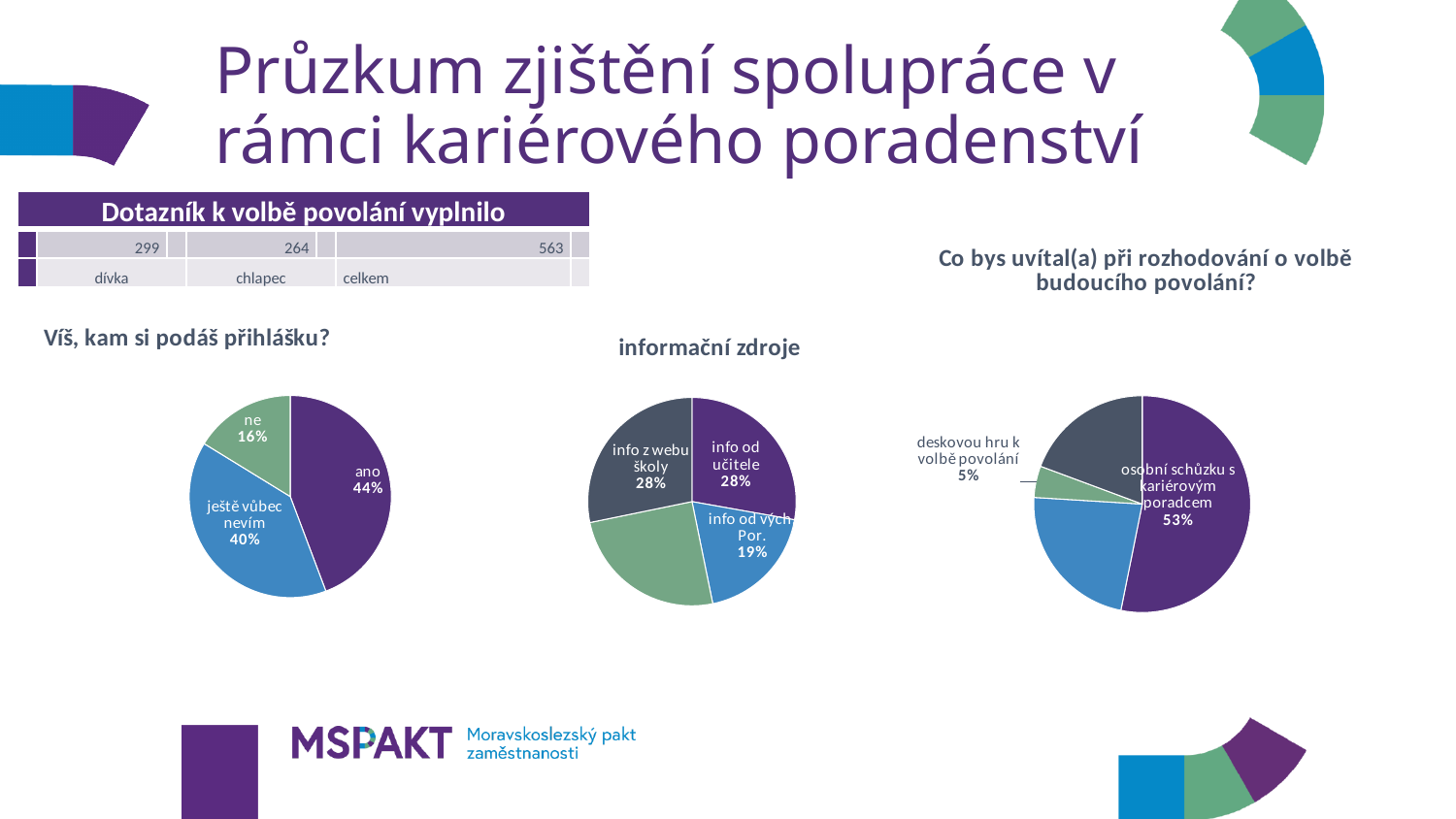
How many slices does the pie chart 'Víš, kam si podáš přihlášku?' have? 3 In the pie chart 'Co bys uvítal(a) při rozhodování o volbě budoucího povolání?', what share is labelled 'deskovou hru k volbě povolání'? 5% In the pie chart 'Víš, kam si podáš přihlášku?', what share is labelled 'ještě vůbec nevím'? 40% In the pie chart 'Víš, kam si podáš přihlášku?', what share is labelled 'ano'? 44% In the pie chart 'informační zdroje', what share is labelled 'info od vých. Por.'? 19% In the pie chart 'Víš, kam si podáš přihlášku?', which category has the smallest share? ne In the pie chart 'informační zdroje', what share is labelled 'info z webu školy'? 28% What type of chart is used for 'informační zdroje'? pie chart In the pie chart 'Co bys uvítal(a) při rozhodování o volbě budoucího povolání?', what share is labelled 'osobní schůzku s kariérovým poradcem'? 53% In the pie chart 'Víš, kam si podáš přihlášku?', what is the difference between the 'ano' share and the 'ne' share? 28% In the pie chart 'informační zdroje', which is larger: 'info od učitele' or 'info od vých. Por.'? info od učitele In the chart 'Dotazník k volbě povolání vyplnilo', what is the value for 'celkem'? 563